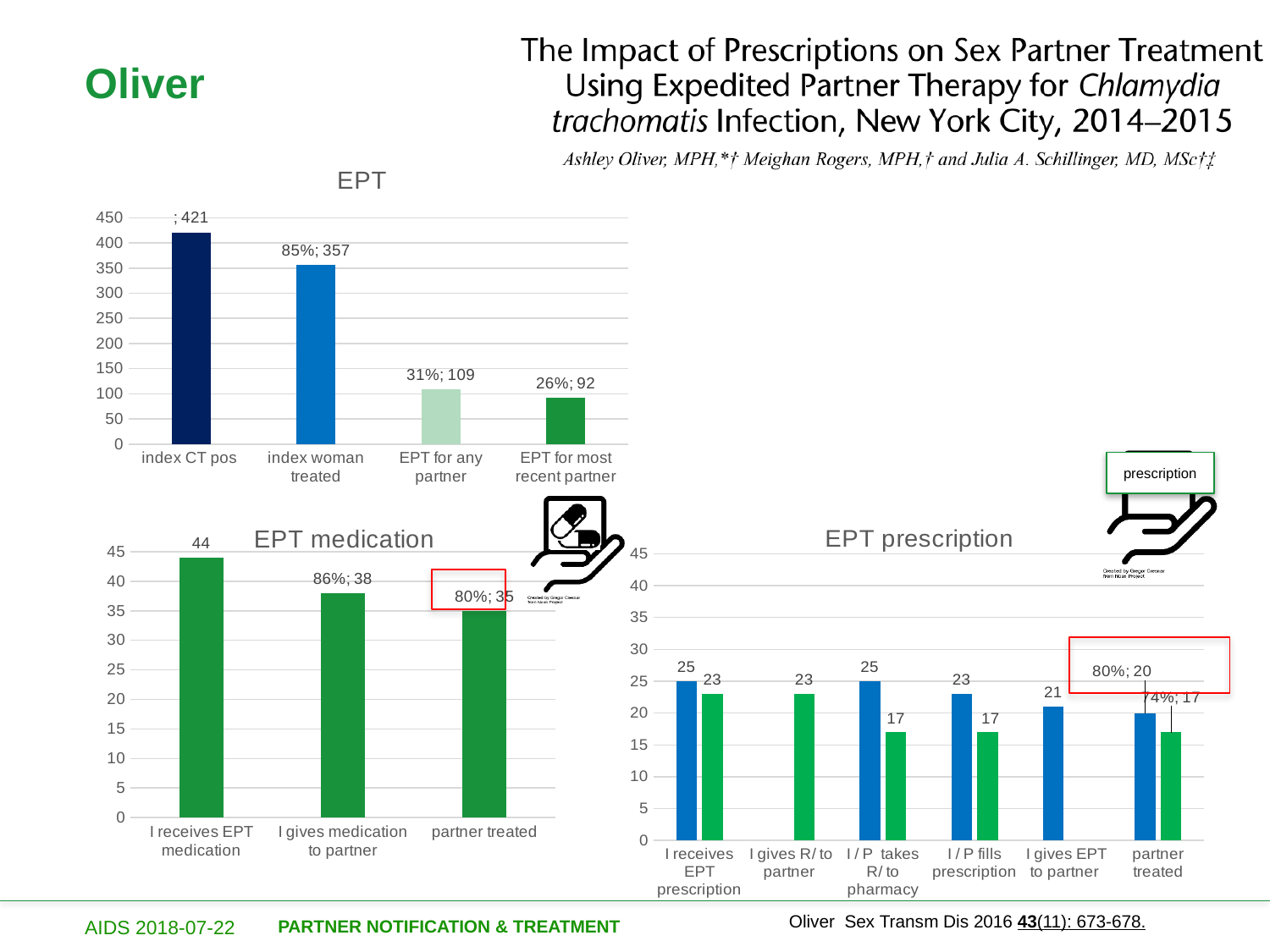
In the EPT chart, what is the difference between the counts for EPT for any partner and EPT for most recent partner? 17 In the EPT prescription chart, what is the data label on the blue bar for partner treated? 80%; 20 In the EPT chart, what is the data label for index woman treated? 85%; 357 In the EPT medication chart, which category has the highest value? I receives EPT medication In the EPT medication chart, what is the value for I receives EPT medication? 44 In the EPT prescription chart, what is the value of the green bar for I / P takes R/ to pharmacy? 17 In the EPT chart, which category has the lowest value? EPT for most recent partner In the EPT medication chart, what is the data label for partner treated? 80%; 35 In the EPT medication chart, do the values rise or fall from left to right along the x axis? fall In the EPT chart, how many categories are shown on the x axis? 4 In the EPT chart, what is the value for index CT pos? 421 What type of chart is the EPT prescription chart? bar chart